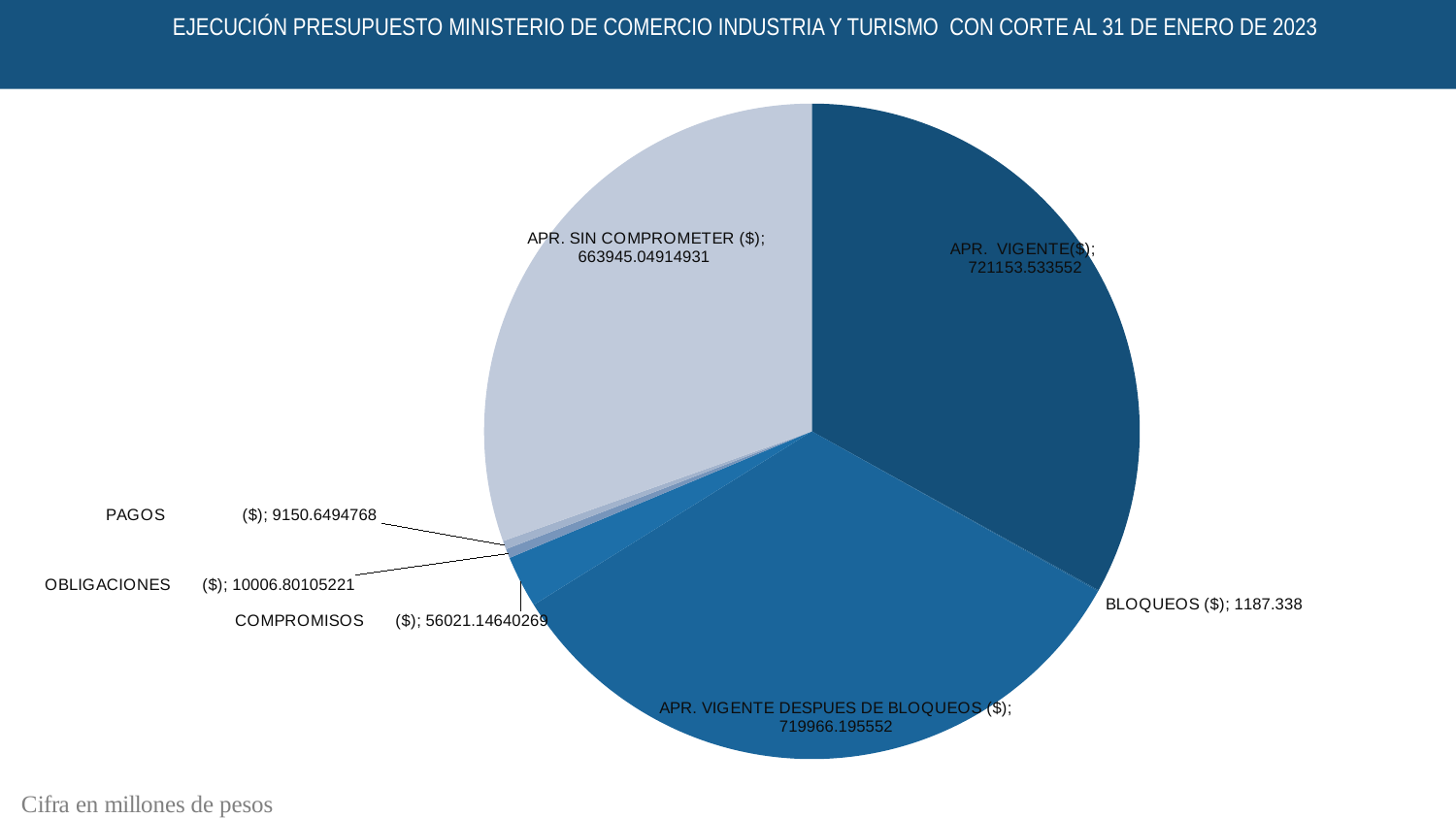
What is the value for APR. VIGENTE ($)? 721153.533552 Which category has the largest value in the pie chart? APR. VIGENTE ($) What is the value for BLOQUEOS ($)? 1187.338 What is the value for APR. SIN COMPROMETER ($)? 663945.04914931 What is the value for APR. VIGENTE DESPUES DE BLOQUEOS ($)? 719966.195552 Which is larger, OBLIGACIONES ($) or PAGOS ($)? OBLIGACIONES ($) Which category has the smallest slice of the pie? BLOQUEOS ($) What is the value for COMPROMISOS ($)? 56021.14640269 What type of chart is shown on the slide? Pie chart What is the difference between APR. VIGENTE ($) and BLOQUEOS ($)? 719966.195552 How many slices does the pie chart have? 7 According to the note at the bottom of the slide, in what unit are the figures expressed? Millones de pesos